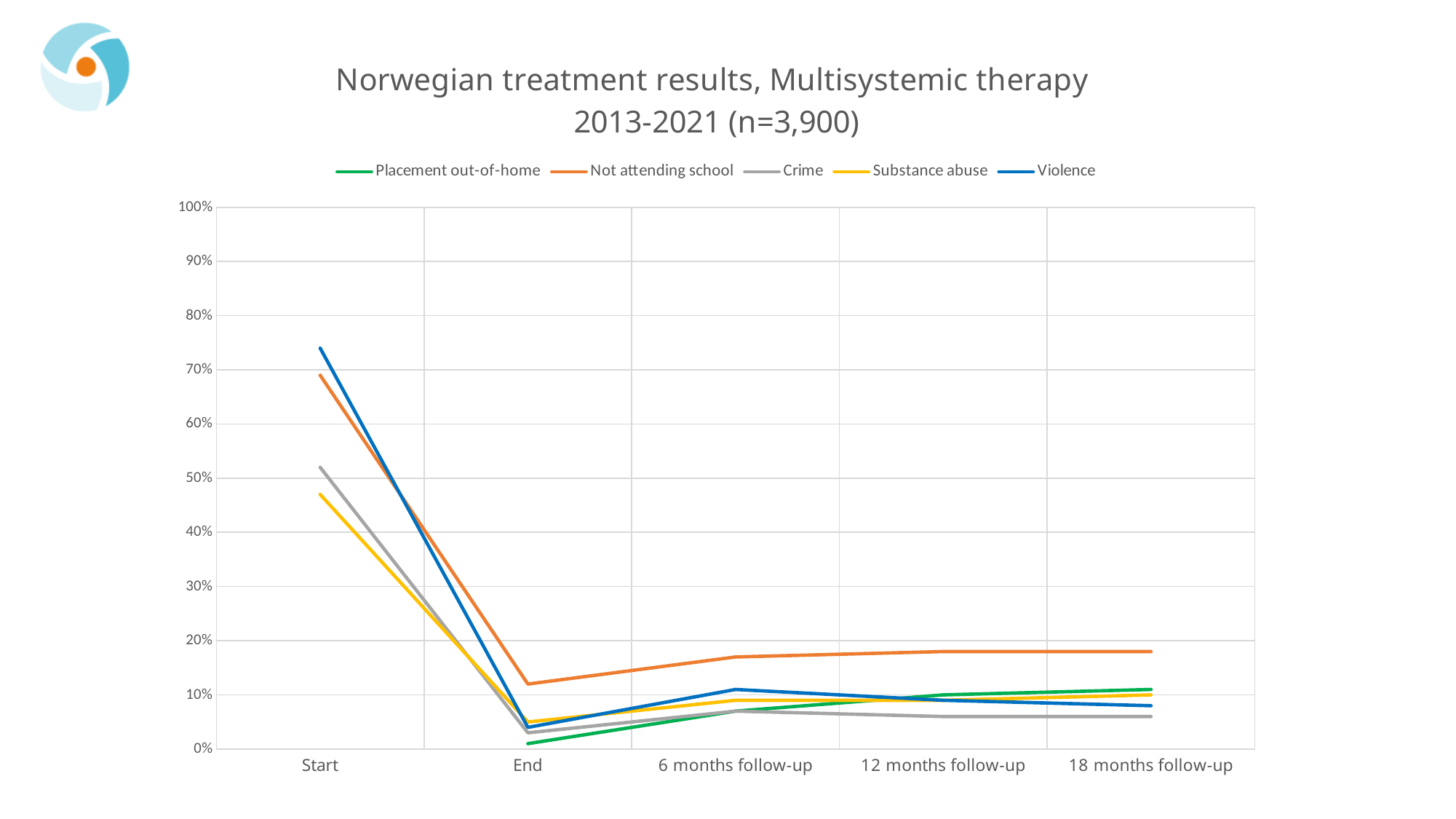
What is the title of the chart? Norwegian treatment results, Multisystemic therapy 2013-2021 (n=3,900) Is the value for Violence at Start greater or less than 70%? greater What kind of chart is shown on the slide? line chart Is the value for Not attending school at 18 months follow-up greater or less than 10%? greater How many time points are shown on the x axis? 5 Which series has the highest value at Start? Violence Is the value for Substance abuse at Start greater or less than 50%? less How many series does the legend list? 5 Which series has the lowest value at Start among those plotted there? Substance abuse Does the Not attending school line rise or fall from Start to End? fall Which series has the lowest value at End? Placement out-of-home Which series has the highest value at 18 months follow-up? Not attending school